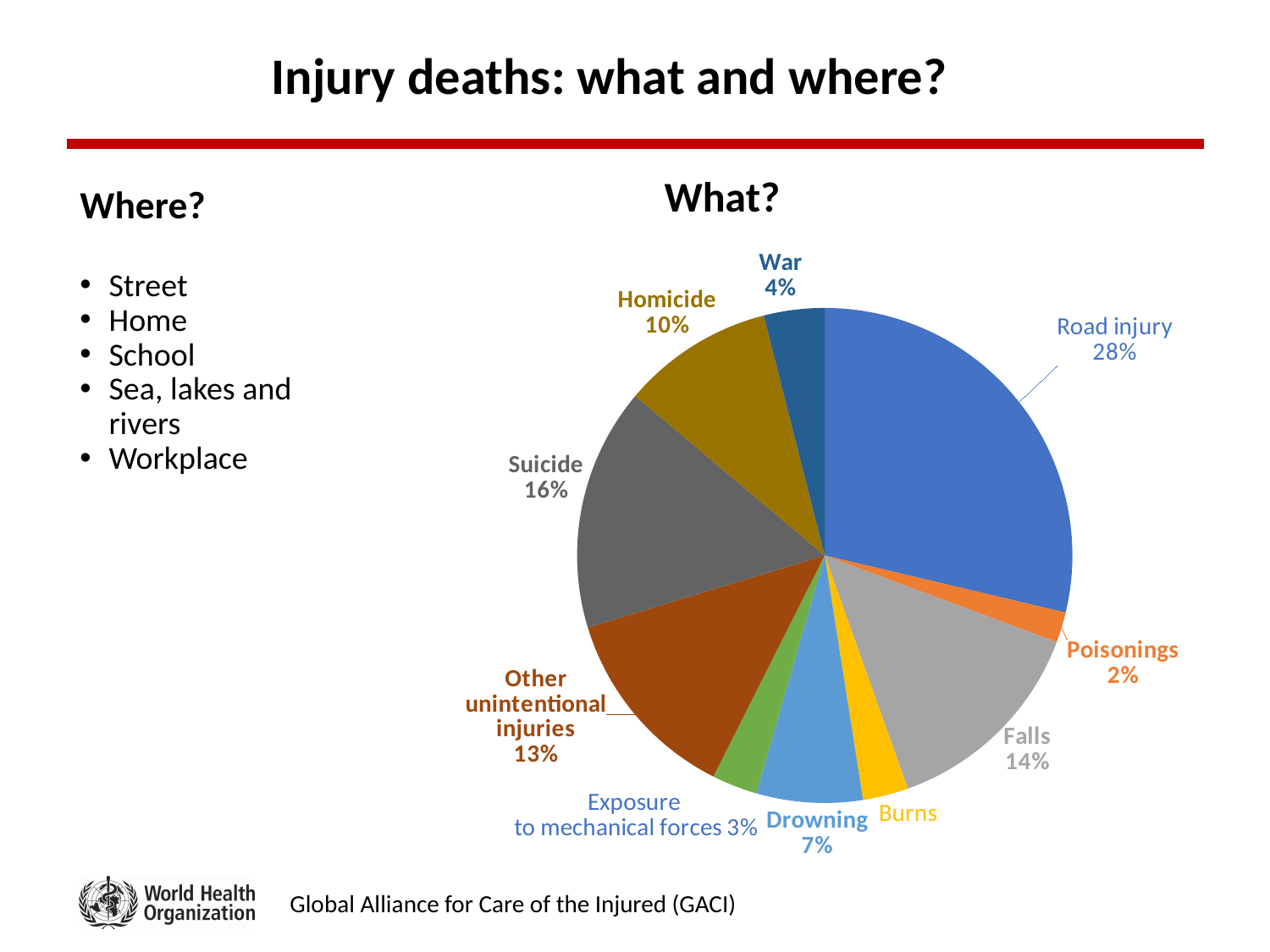
What is the value shown for Falls? 14% How many slices does the pie chart have? 10 What is the title of the pie chart? What? Which category has the largest slice of the pie? Road injury What percentage is shown for Other unintentional injuries? 13% Which category has the smallest slice of the pie? Poisonings What kind of chart is shown under "What?"? pie chart What is the difference in percentage points between Road injury and Suicide? 12 What percentage of the pie is Suicide? 16% What share does Exposure to mechanical forces have? 3% Which is larger, Homicide or Drowning? Homicide What share of injury deaths is attributed to Road injury? 28%